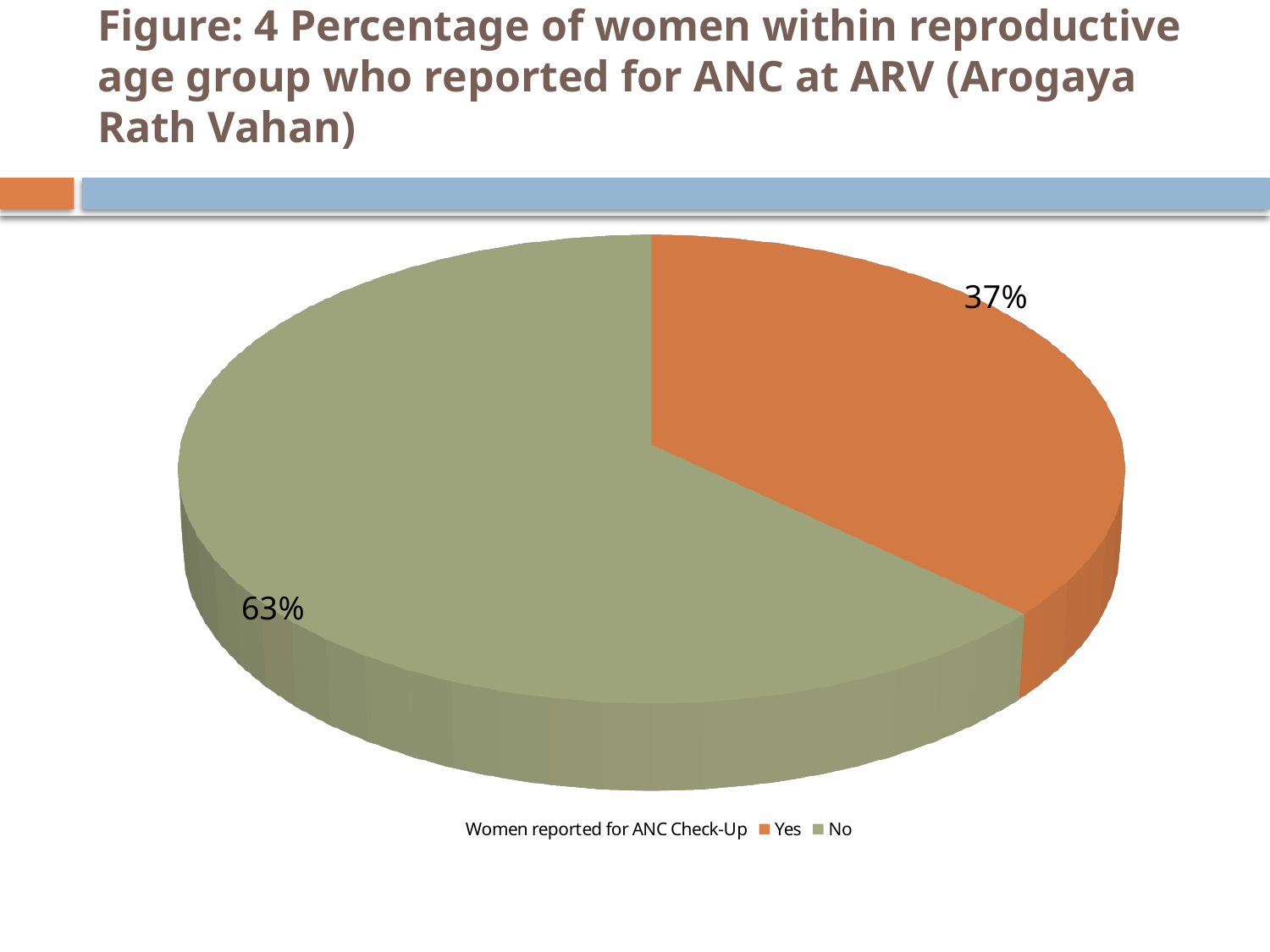
What share of the pie does the No slice represent? 63% How many slices does the pie chart have? 2 What percentage of women reported for ANC check-up (Yes)? 37% Which category has the smaller share of the pie? Yes What series name is shown in the legend of the chart? Women reported for ANC Check-Up What colour is the Yes slice in the pie chart? orange What kind of chart is shown on the slide? pie chart What percentage of women did not report for ANC check-up (No)? 63% What is the difference in percentage points between the No and Yes slices? 26 Which category has the larger share of the pie, Yes or No? No Is the share for Yes larger or smaller than the share for No? smaller Is the share for Yes greater or less than 50%? less